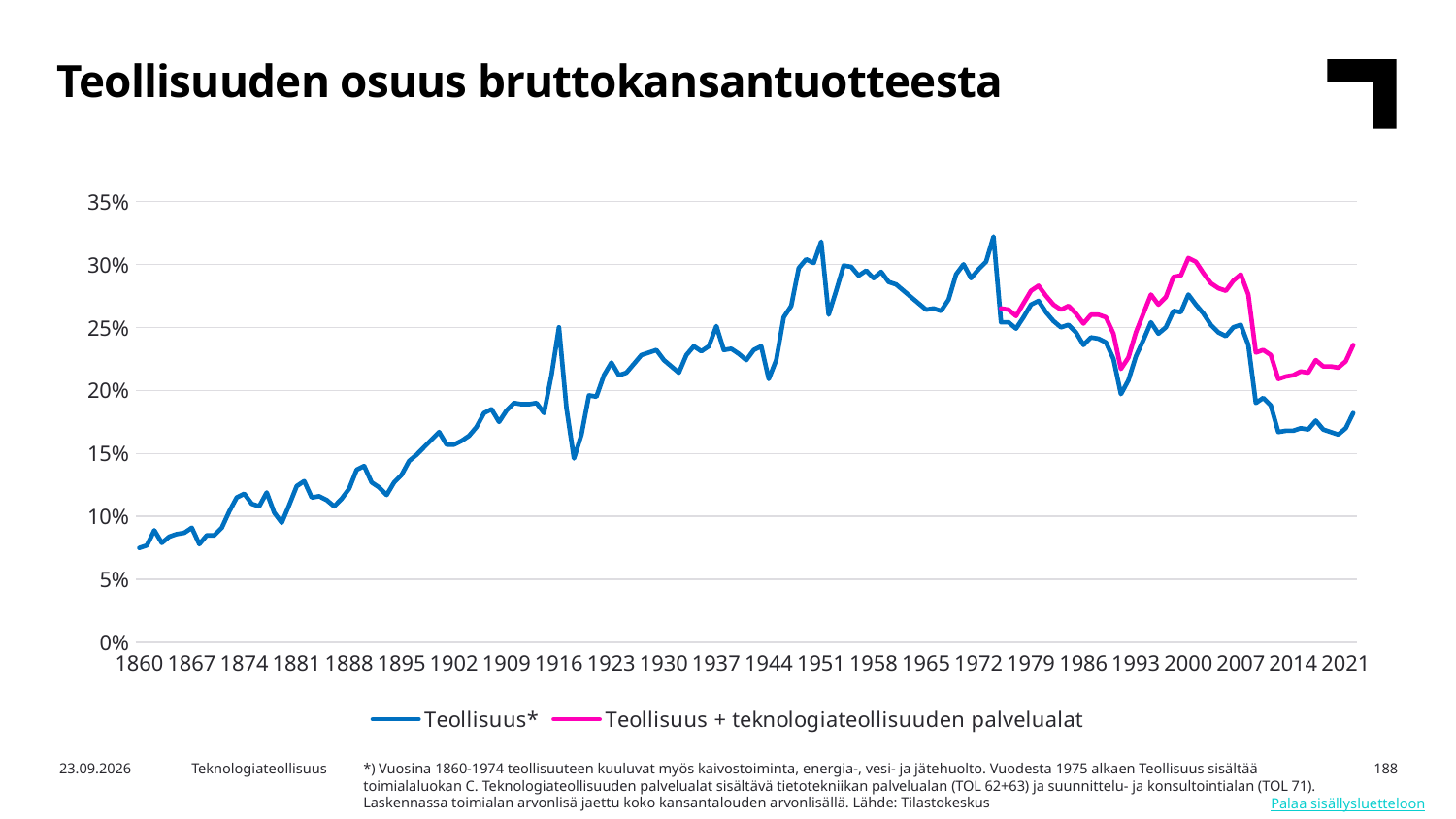
Which series is drawn in pink (magenta)? Teollisuus + teknologiateollisuuden palvelualat Is the value for Teollisuus* in 2021 greater or less than 20%? less Does the Teollisuus* series generally rise or fall between 1860 and 1951? Rise What is the highest value shown on the y axis? 35% Is the peak value of Teollisuus* around 1951 greater or less than 30%? greater Does the Teollisuus* series rise or fall between 2007 and 2014? Fall In 2021, which series has the higher value: Teollisuus* or Teollisuus + teknologiateollisuuden palvelualat? Teollisuus + teknologiateollisuuden palvelualat Is the value for Teollisuus* in 1860 greater or less than 10%? less How many series does the legend list? 2 What kind of chart is shown on the slide? Line chart What is the title of the chart? Teollisuuden osuus bruttokansantuotteesta